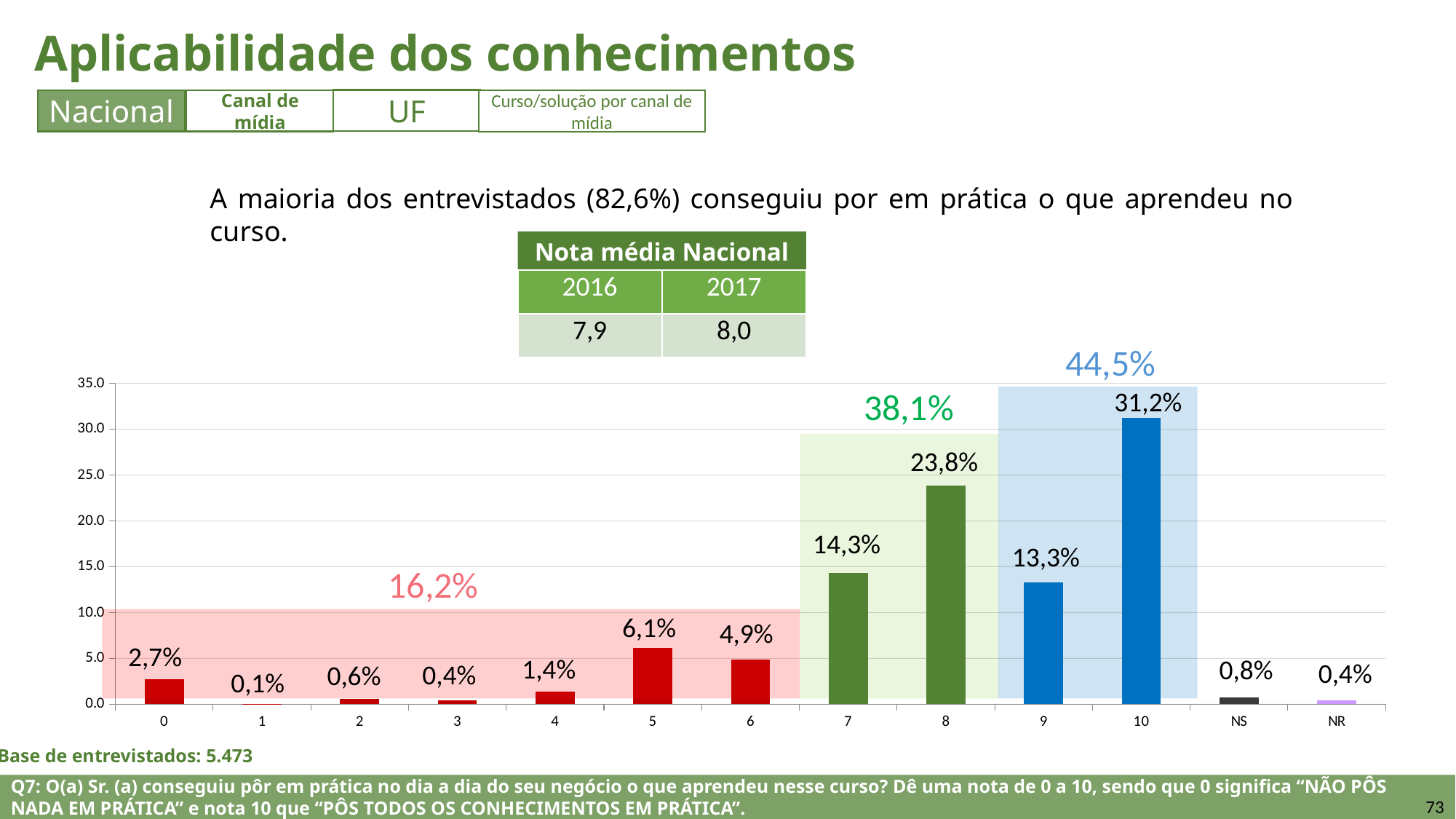
Which category has the lowest value? 1 What percentage label is shown above the blue shaded group covering categories 9 and 10? 44,5% Which is larger, the value for category 7 or the value for category 9? 7 What is the difference between the values for category 10 and category 8? 7,4% What is the value for category 0? 2,7% What is the value for the NS category? 0,8% Which category has the highest value? 10 Is the value for category 8 greater or less than 20.0? greater What is the value for category 8? 23,8% How many categories are shown on the x axis? 13 What kind of chart is shown on the slide? bar chart What is the value for category 10? 31,2%